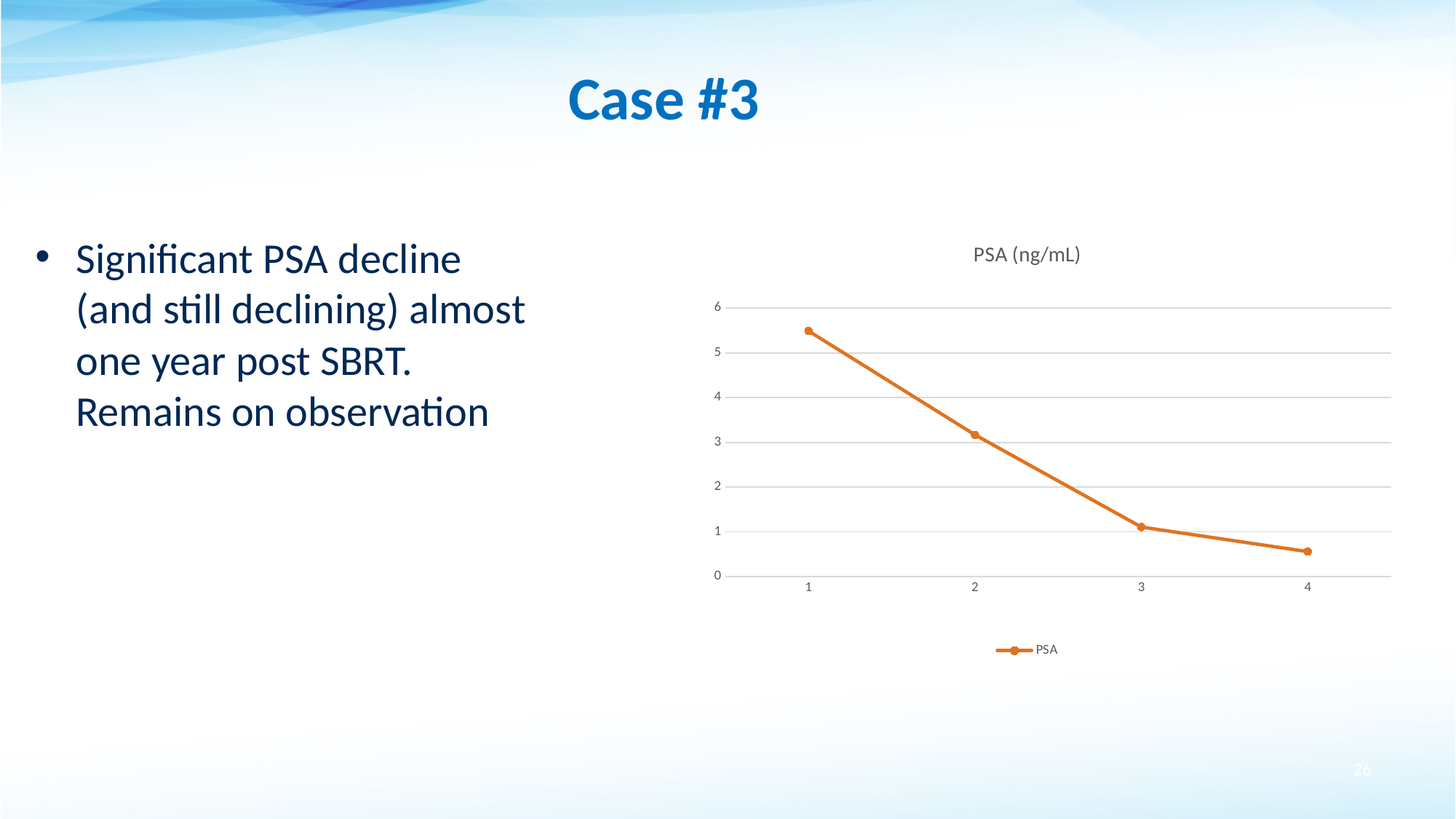
How many data points are plotted on the line? 4 At which x-axis point is the PSA value highest? 1 What is the title of the chart? PSA (ng/mL) At which x-axis point is the PSA value lowest? 4 Is the PSA value at point 1 greater or less than 5? greater Which has the larger PSA value, point 2 or point 3? point 2 What is the name of the series in the legend? PSA What kind of chart is shown on the slide? line chart Is the PSA value at point 4 greater or less than 1? less How many series does the legend list? 1 Do the PSA values rise or fall from point 1 to point 4? fall